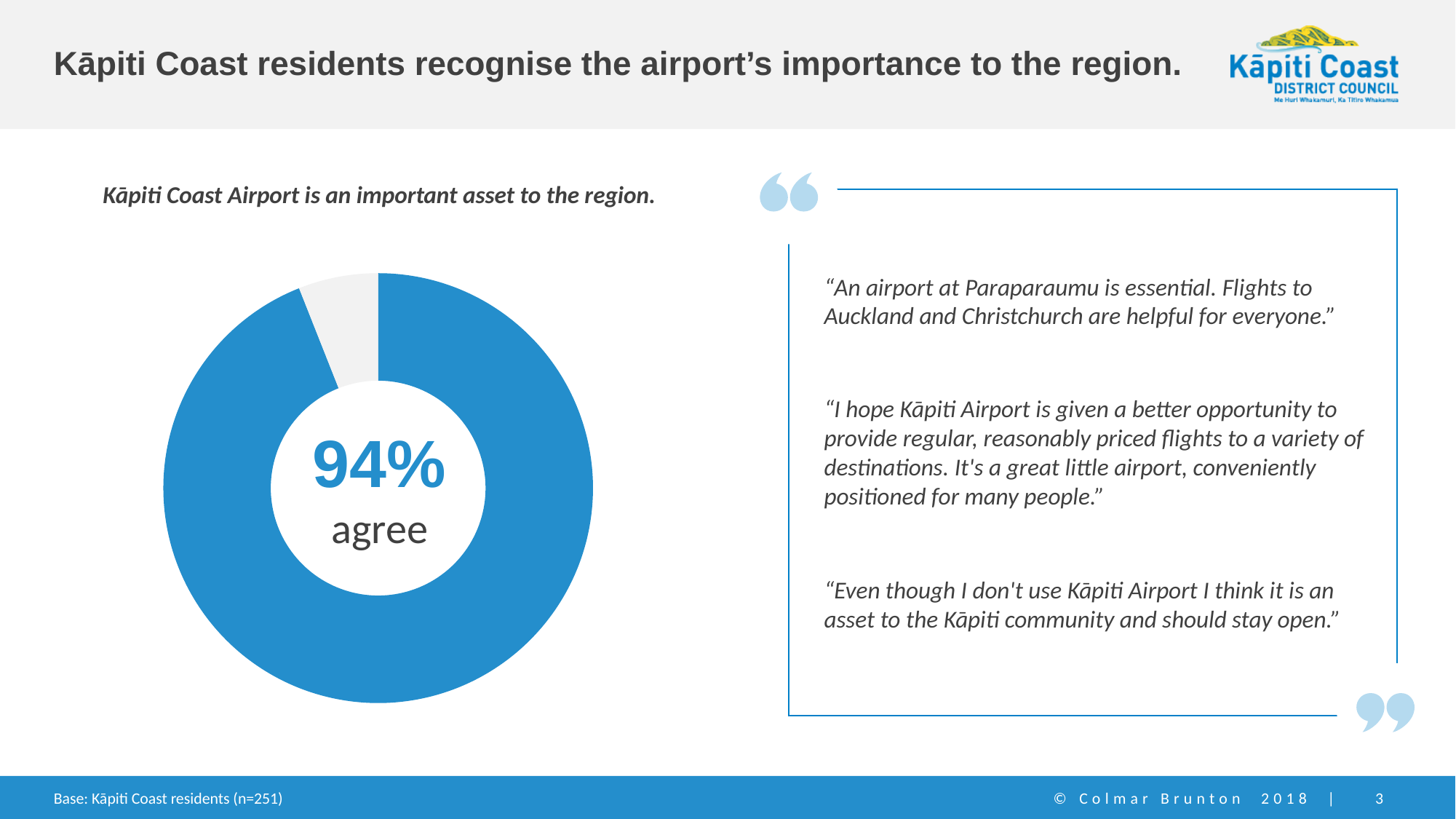
What kind of chart is shown on the slide? pie chart (donut) What share of the donut chart is not covered by the 'agree' slice? 6% What percentage of Kāpiti Coast residents agree that Kāpiti Coast Airport is an important asset to the region? 94% How many slices does the donut chart have? 2 What is the base sample size for the chart? n=251 Which slice of the donut chart is larger, the 'agree' slice or the remaining slice? agree Is the share of residents who agree greater or less than 90%? greater Which slice of the donut chart is the largest? agree (94%) Is the share of residents who agree greater or less than 50%? greater What statement does the donut chart measure agreement with? Kāpiti Coast Airport is an important asset to the region.